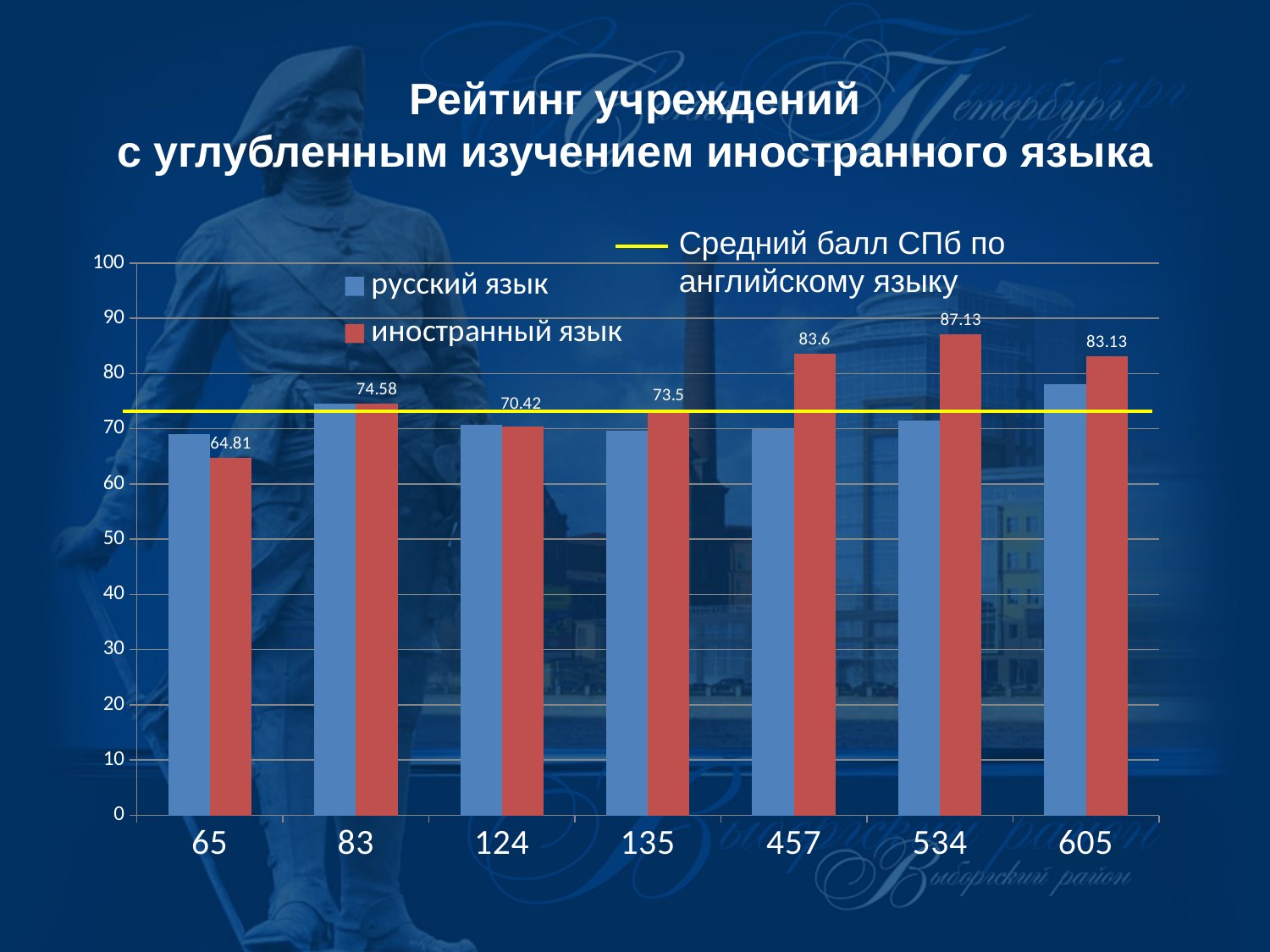
Is the value of русский язык for category 457 greater or less than 80? less What is the value of иностранный язык for category 534? 87.13 What is the difference between the иностранный язык values for categories 534 and 65? 22.32 What is the value of иностранный язык for category 457? 83.6 Which category has the highest value for иностранный язык? 534 Which category has the larger иностранный язык value, 83 or 135? 83 What does the yellow horizontal line represent according to the legend? Средний балл СПб по английскому языку Is the value of русский язык for category 605 greater or less than 70? greater How many categories are shown on the x axis? 7 Which category has the lowest value for иностранный язык? 65 What type of chart is shown on the slide? bar chart What is the value of иностранный язык for category 65? 64.81